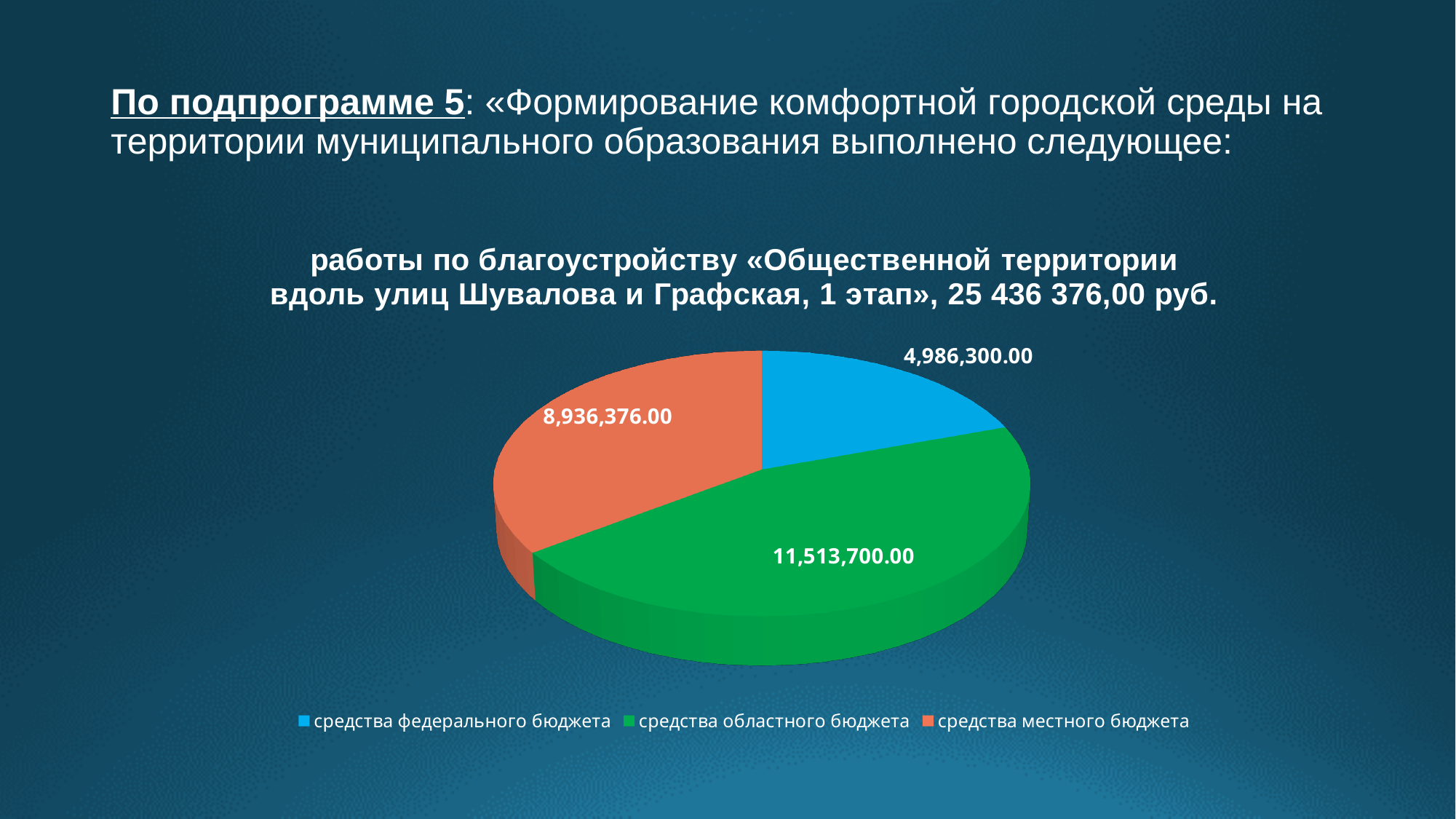
Which is larger, средства местного бюджета or средства федерального бюджета? средства местного бюджета What is the total of all three slices of the pie chart? 25,436,376.00 Which budget source has the smallest slice of the pie? средства федерального бюджета How many slices does the pie chart have? 3 Which budget source has the largest slice of the pie? средства областного бюджета What is the difference between средства местного бюджета and средства федерального бюджета? 3,950,076.00 What is the value for средства местного бюджета? 8,936,376.00 What is the value for средства федерального бюджета? 4,986,300.00 What is the difference between средства областного бюджета and средства федерального бюджета? 6,527,400.00 Which colour represents средства областного бюджета in the pie chart? green What kind of chart is shown on the slide? pie chart What is the value for средства областного бюджета? 11,513,700.00